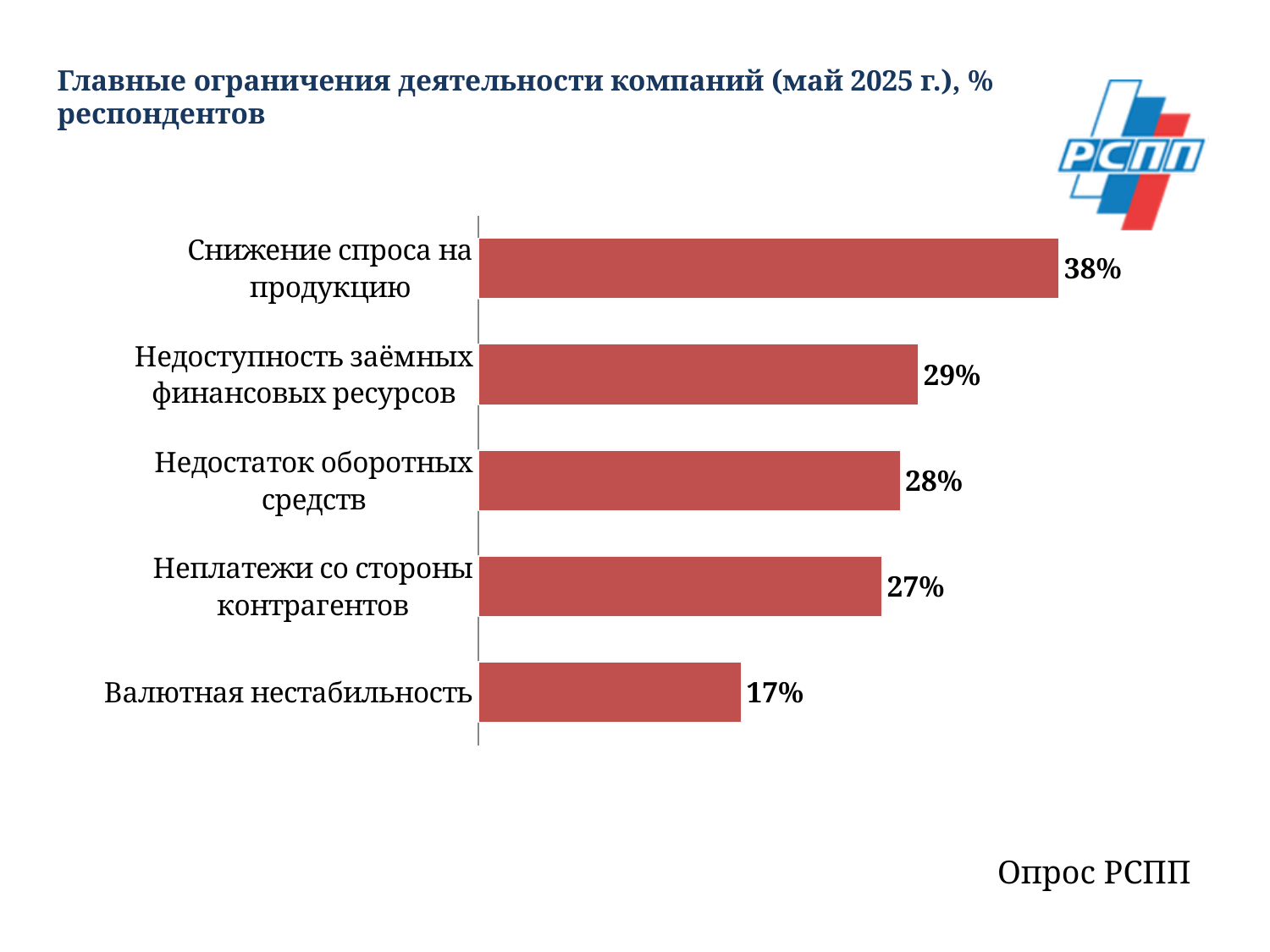
Which limitation has the highest share of respondents? Снижение спроса на продукцию How many limitations (categories) are shown in the chart? 5 What is the difference between «Недоступность заёмных финансовых ресурсов» and «Недостаток оборотных средств»? 1 percentage point What is the value for «Недоступность заёмных финансовых ресурсов»? 29% What is the value for «Неплатежи со стороны контрагентов»? 27% What is the value for «Валютная нестабильность»? 17% What kind of chart is shown on the slide? Bar chart Which is larger: the value for «Недостаток оборотных средств» or for «Валютная нестабильность»? Недостаток оборотных средств What percentage of respondents named «Снижение спроса на продукцию» as a main limitation? 38% Which limitation has the lowest share of respondents? Валютная нестабильность What is the title of the chart? Главные ограничения деятельности компаний (май 2025 г.), % респондентов What is the difference between «Снижение спроса на продукцию» and «Валютная нестабильность»? 21 percentage points